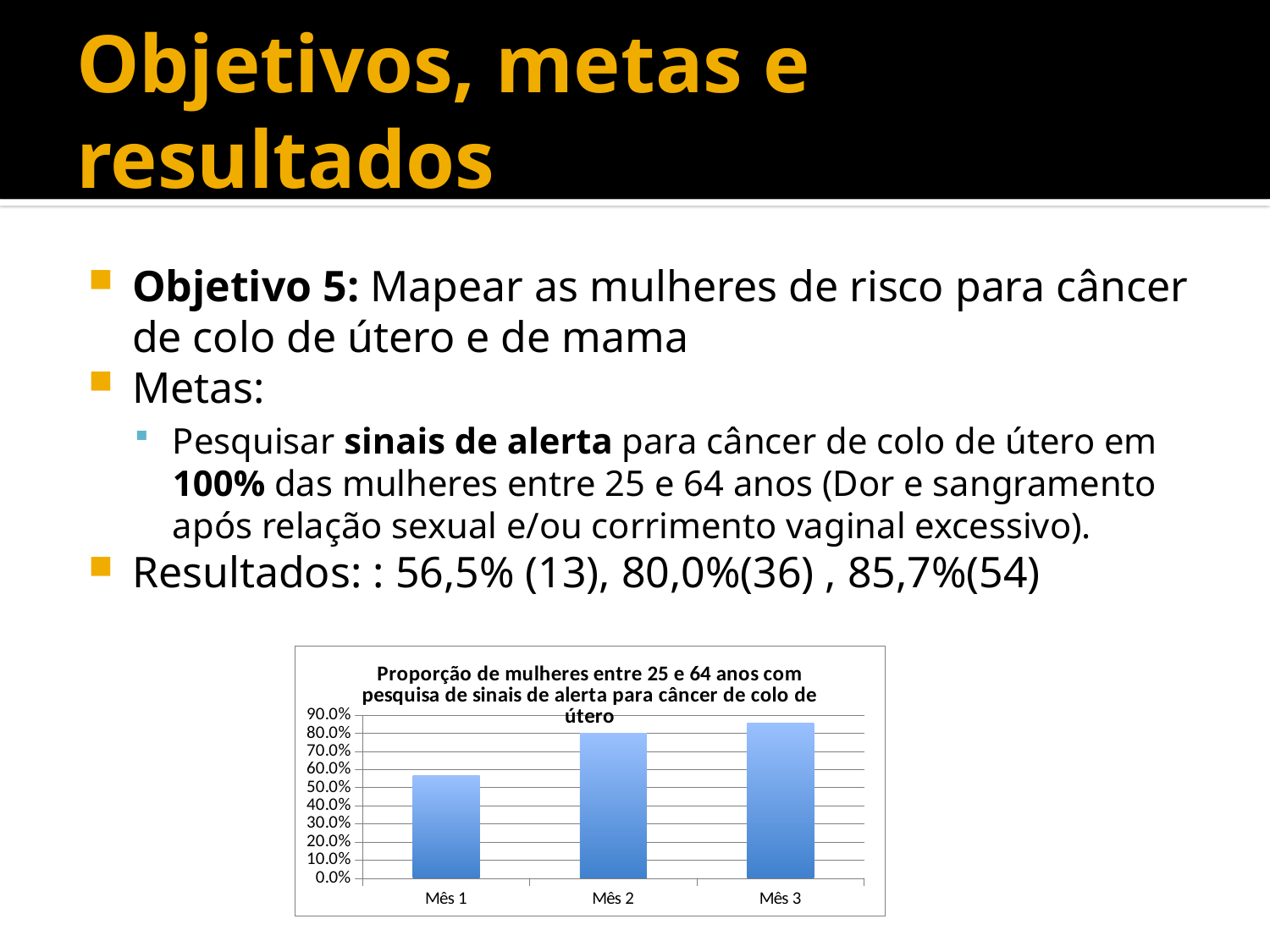
Which month has the highest bar in the chart? Mês 3 Is the value for Mês 1 greater or less than 50.0%? greater What colour are the bars in the chart? blue What is the title of the chart? Proporção de mulheres entre 25 e 64 anos com pesquisa de sinais de alerta para câncer de colo de útero Is the value for Mês 3 greater or less than 90.0%? less Which month has the lowest bar in the chart? Mês 1 Is the value for Mês 3 greater or less than 80.0%? greater Do the values rise or fall from Mês 1 to Mês 3? rise Which is larger, the value for Mês 1 or the value for Mês 2? Mês 2 How many categories (months) are shown on the x axis of the chart? 3 What kind of chart is shown on the slide? bar chart